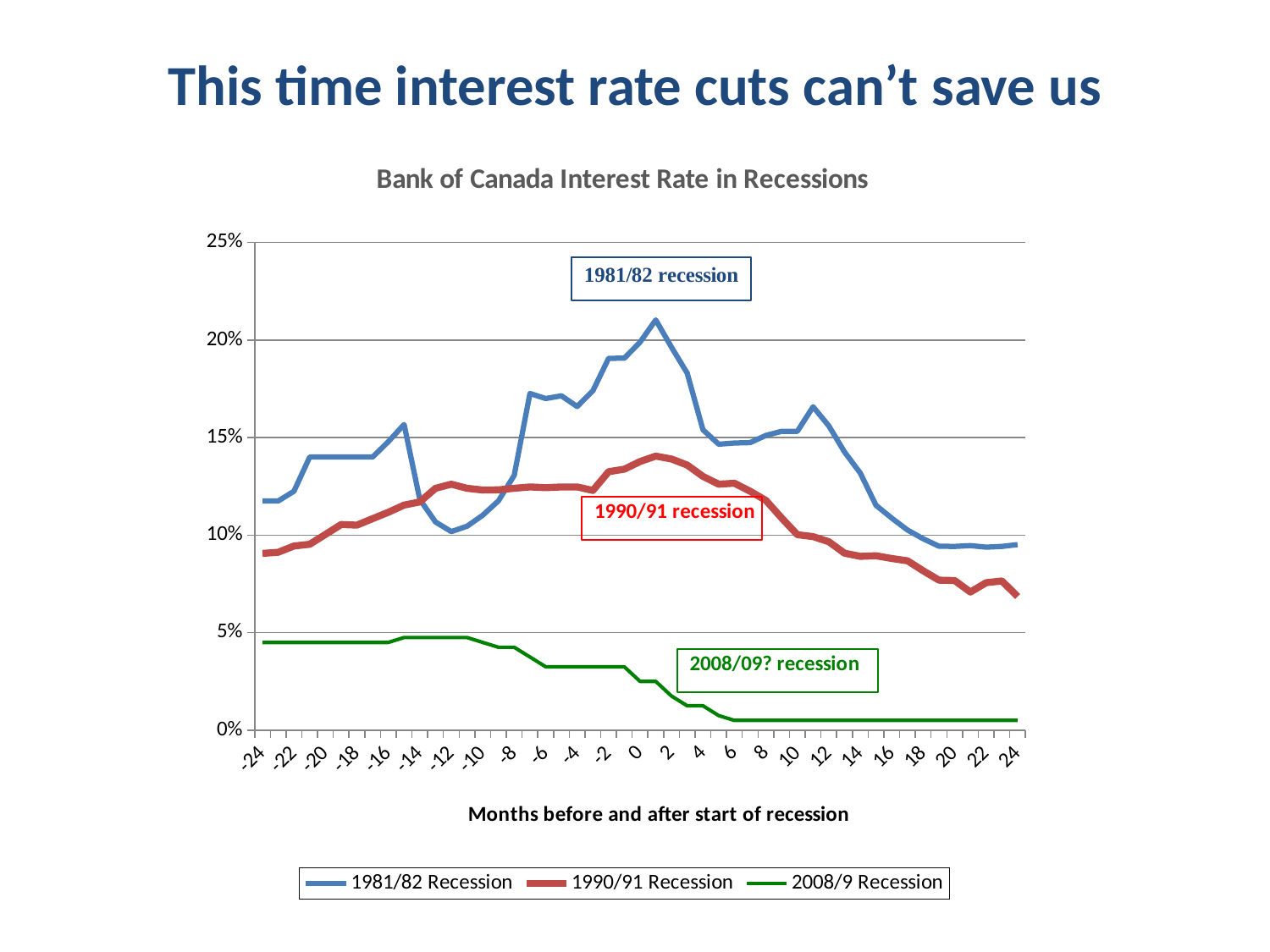
At month 0, which series has the higher interest rate, 1981/82 Recession or 1990/91 Recession? 1981/82 Recession Is the 2008/9 Recession value at month 24 greater or less than 5%? less Is the 1981/82 Recession value at month -24 greater or less than 10%? greater Which series reaches the highest interest rate on the chart? 1981/82 Recession Is the 1990/91 Recession value at month -24 greater or less than 10%? less Does the 2008/9 Recession series rise or fall from month -24 to month 24? fall How many series does the legend list? 3 Which series has the lowest interest rate across the whole chart? 2008/9 Recession What is the title of the chart? Bank of Canada Interest Rate in Recessions What is the label on the x axis of the chart? Months before and after start of recession What kind of chart is shown on the slide? line chart